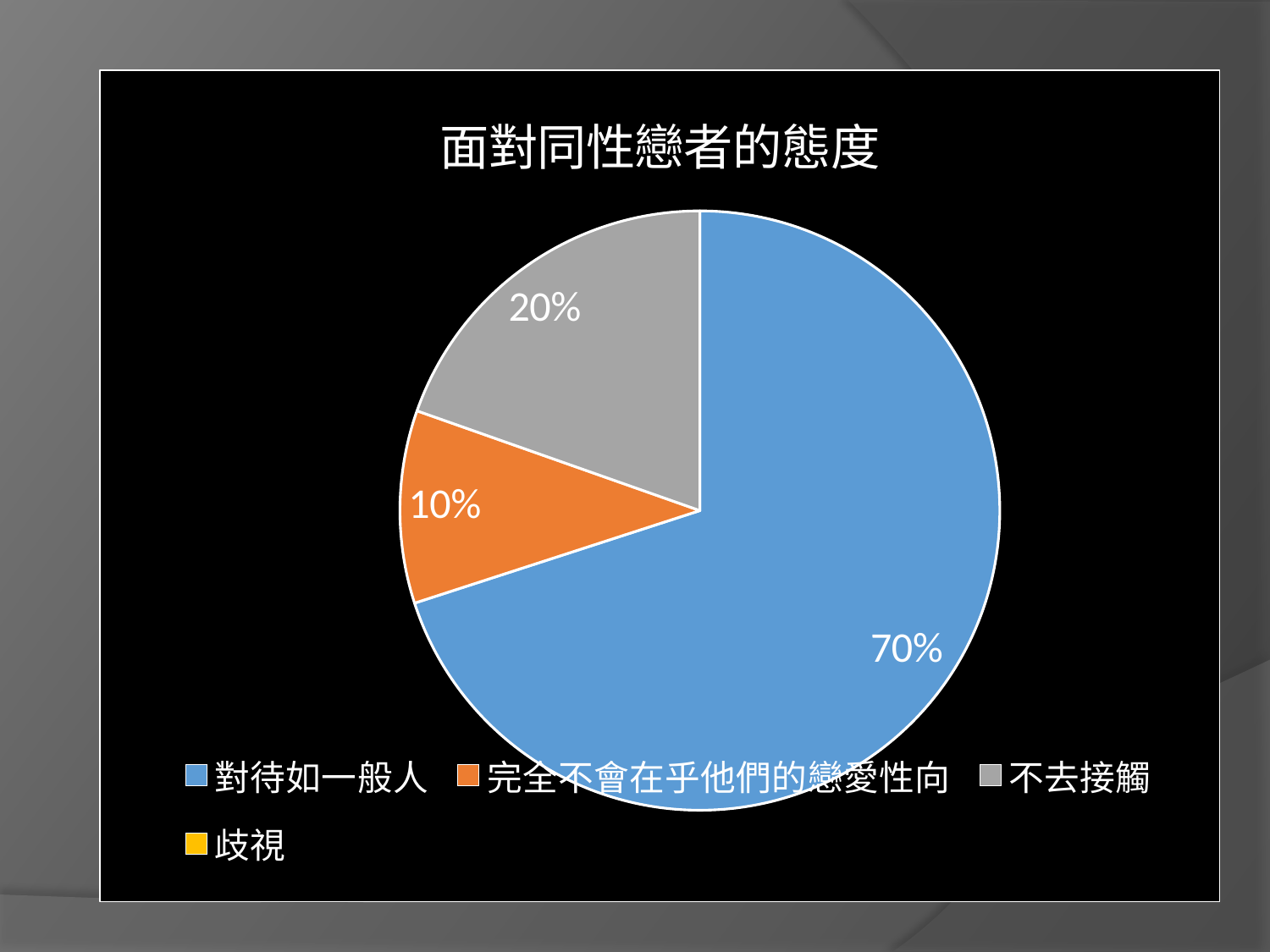
What is the difference in percentage points between 不去接觸 and 完全不會在乎他們的戀愛性向? 10 Which is larger, the slice for 不去接觸 or the slice for 完全不會在乎他們的戀愛性向? 不去接觸 What percentage is shown for 不去接觸? 20% What share of the pie does 對待如一般人 take? 70% What is the difference in percentage points between 對待如一般人 and 不去接觸? 50 What is the title of the chart? 面對同性戀者的態度 How many categories does the legend list? 4 What colour is the slice for 不去接觸? Grey What kind of chart is shown on the slide? Pie chart What percentage is shown for 完全不會在乎他們的戀愛性向? 10% Which category has the largest slice of the pie? 對待如一般人 What percentage of the pie is labelled for 對待如一般人? 70%